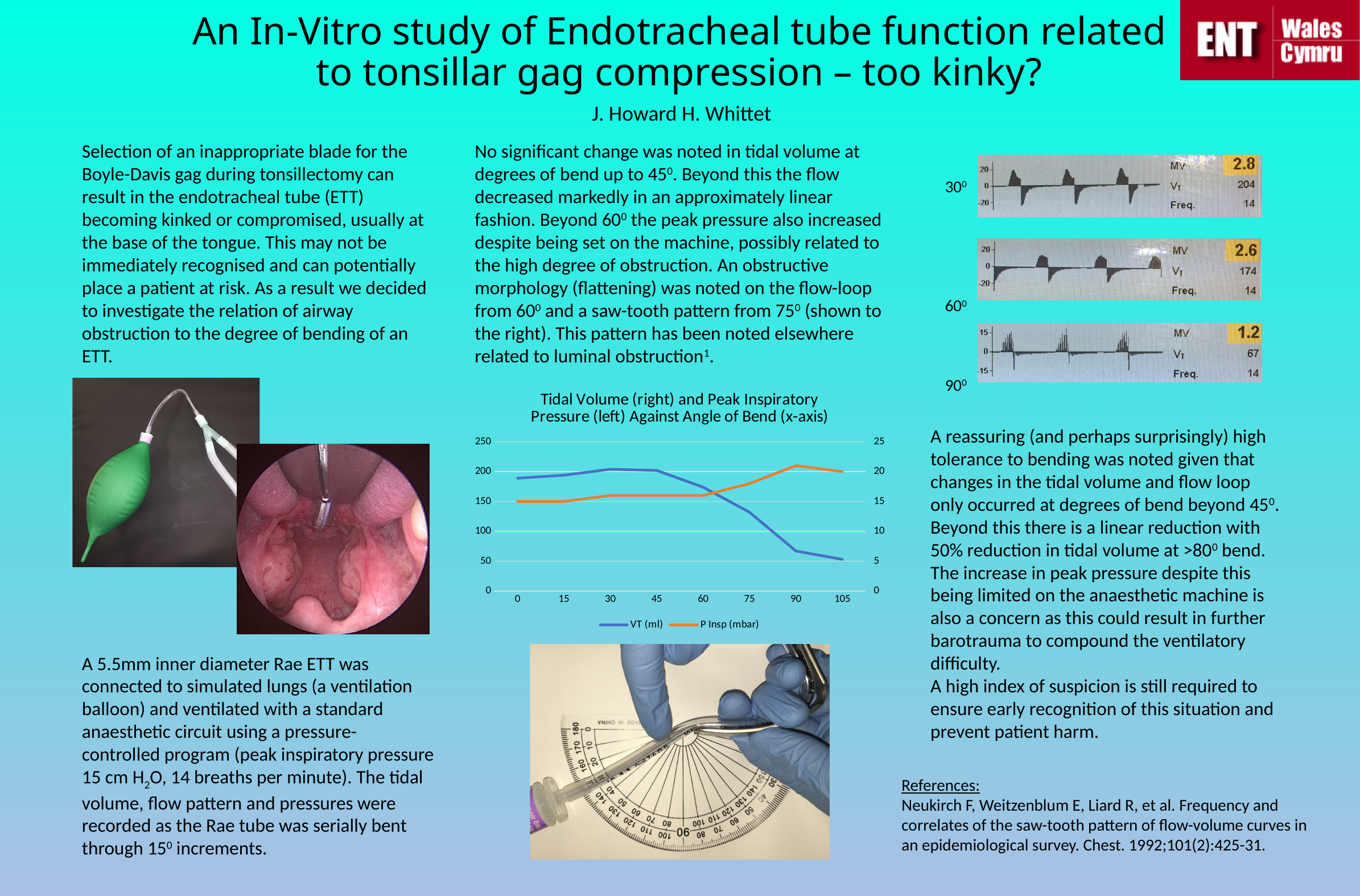
Does the VT (ml) series rise or fall overall as the angle of bend increases from 45 to 105? fall What is the highest value shown on the left vertical axis of the chart? 250 At which angle of bend does the P Insp (mbar) series reach its highest value? 90 How many angle-of-bend points are plotted along the x axis of the chart? 8 At which angle of bend is the VT (ml) series at its lowest value? 105 Is the VT (ml) value at an angle of 105 greater or less than 100? less Is the P Insp (mbar) value at an angle of 90 greater or less than 20 on the right axis? greater Which series in the chart is drawn in orange? P Insp (mbar) How many series does the chart legend list? 2 Is the VT (ml) value at an angle of 0 greater or less than 150? greater What kind of chart is shown on the slide? line chart